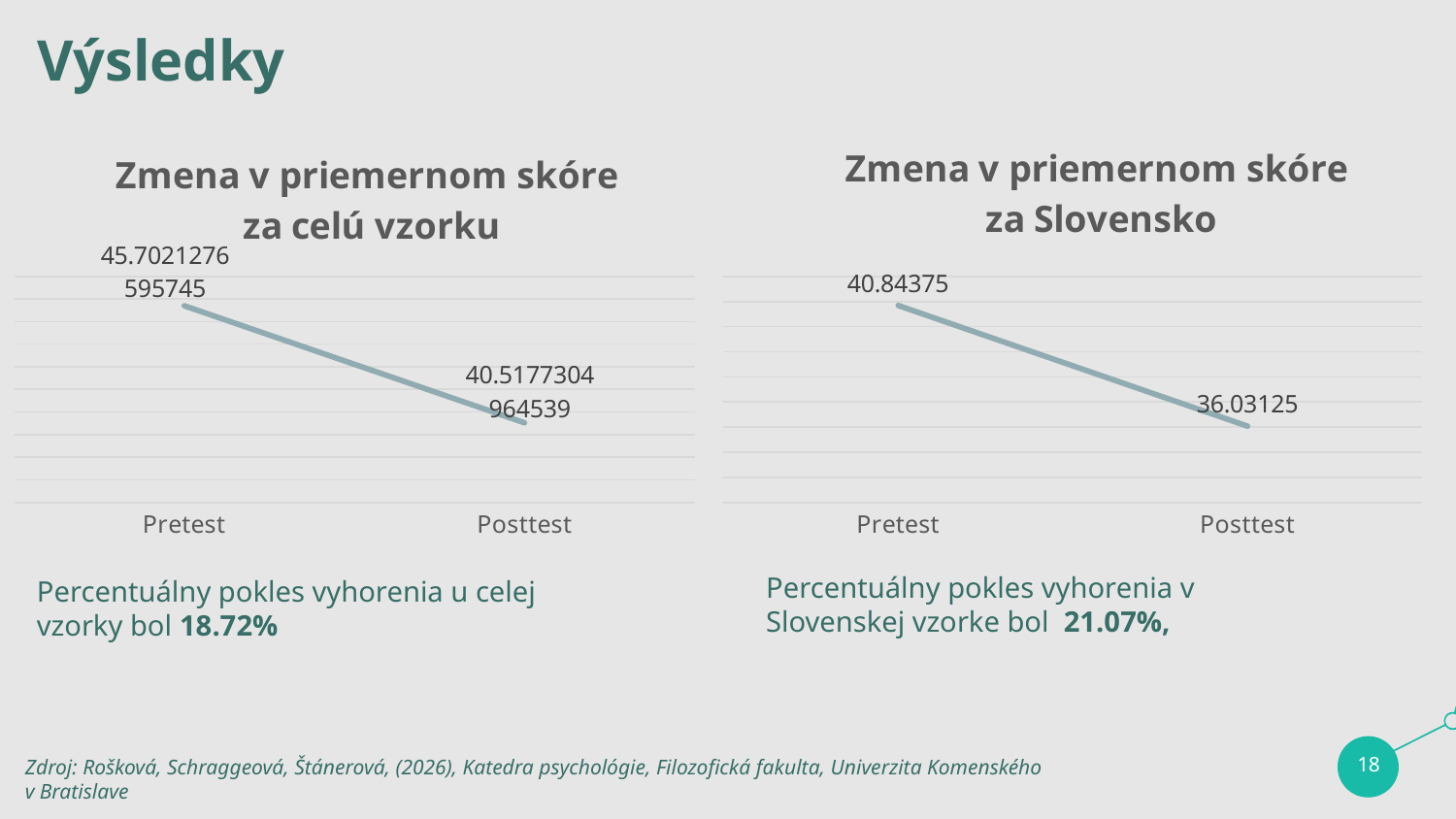
In the chart titled "Zmena v priemernom skóre za celú vzorku", what is the value for Pretest? 45.7021276595745 In the chart titled "Zmena v priemernom skóre za celú vzorku", do the values rise or fall from Pretest to Posttest? fall In the chart titled "Zmena v priemernom skóre za Slovensko", which point has the lowest value? Posttest In the chart titled "Zmena v priemernom skóre za celú vzorku", what is the value for Posttest? 40.5177304964539 In the chart titled "Zmena v priemernom skóre za celú vzorku", which point is higher, Pretest or Posttest? Pretest In the chart titled "Zmena v priemernom skóre za Slovensko", what is the difference between the Pretest and Posttest values? 4.8125 In the chart titled "Zmena v priemernom skóre za Slovensko", what is the value for Posttest? 36.03125 In the chart titled "Zmena v priemernom skóre za Slovensko", what is the value for Pretest? 40.84375 What is the title of the chart on the right of the slide? Zmena v priemernom skóre za Slovensko How many data points are plotted in the chart titled "Zmena v priemernom skóre za Slovensko"? 2 In the chart titled "Zmena v priemernom skóre za Slovensko", do the values rise or fall from Pretest to Posttest? fall What kind of chart is the chart on the left of the slide? line chart